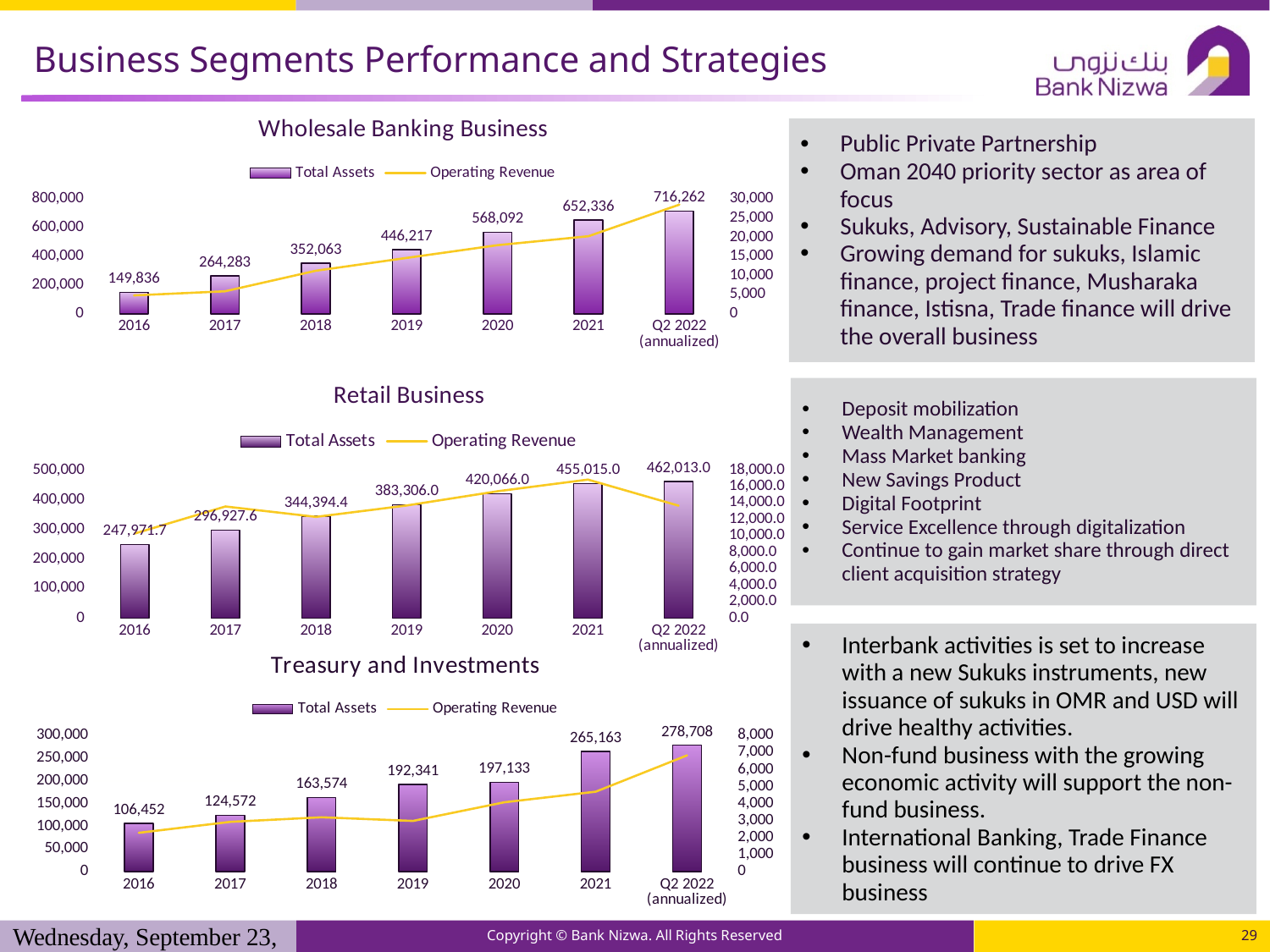
In the Wholesale Banking Business chart, which period has the lowest Total Assets? 2016 How many periods are shown on the x axis of the Retail Business chart? 7 In the Treasury and Investments chart, which is larger, Total Assets in 2019 or in 2020? 2020 In the Wholesale Banking Business chart, what is the Total Assets value for 2019? 446,217 In the Treasury and Investments chart, what is the difference in Total Assets between Q2 2022 (annualized) and 2021? 13,545 In the Wholesale Banking Business chart, what is the difference in Total Assets between 2021 and 2020? 84,244 In the Retail Business chart, which period has the highest Total Assets? Q2 2022 (annualized) In the Wholesale Banking Business chart, do the Total Assets values rise or fall from 2016 to Q2 2022 (annualized)? rise How many series does the legend of the Treasury and Investments chart list? 2 In the Treasury and Investments chart, what is the Total Assets value for Q2 2022 (annualized)? 278,708 In the Retail Business chart, what is the Total Assets value for 2018? 344,394.4 In the Wholesale Banking Business chart, is the Operating Revenue value for Q2 2022 (annualized) greater or less than 20,000? greater